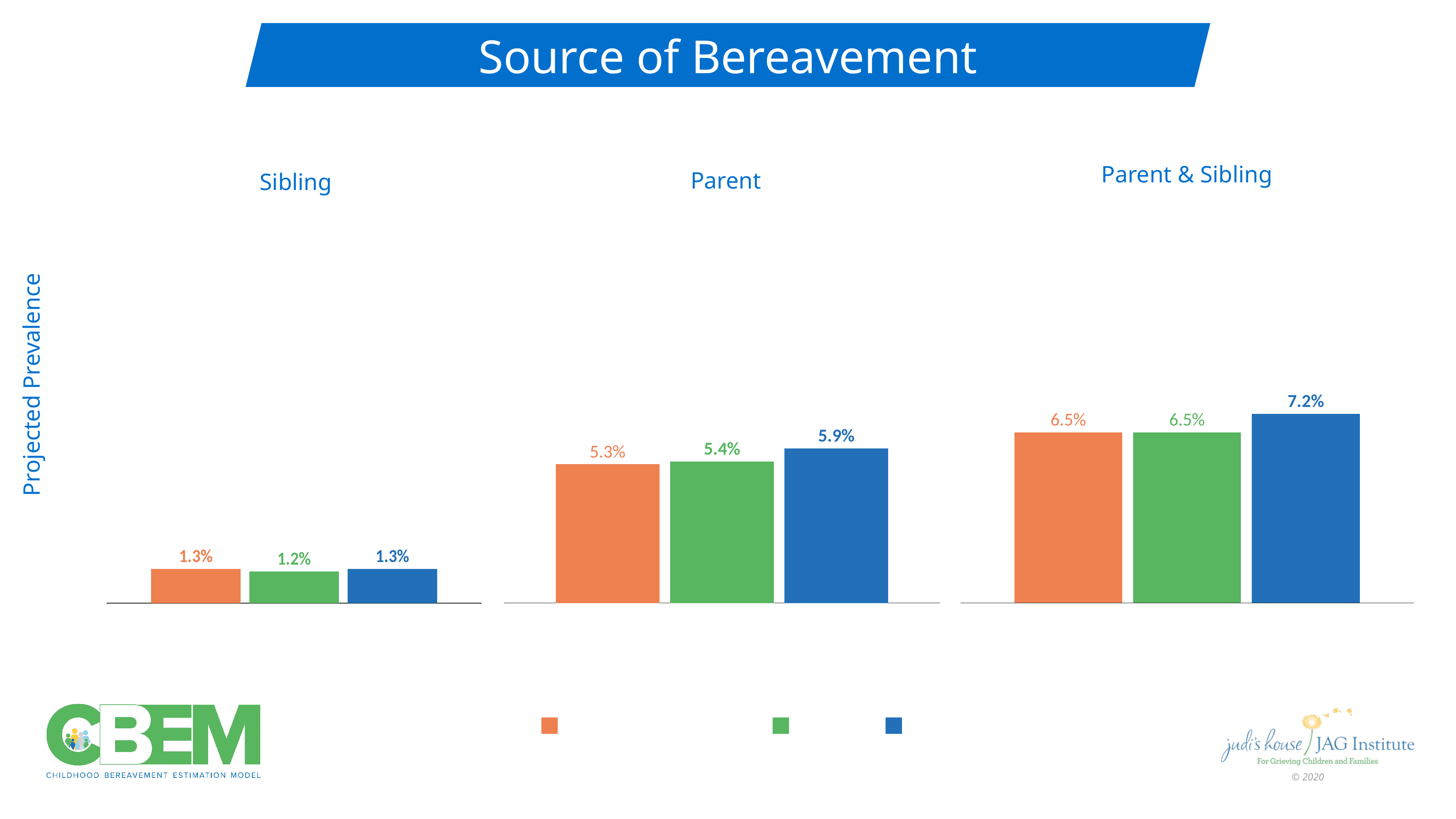
What type of chart is used on this slide? bar chart In the Parent chart, which coloured bar has the highest value? blue In the Sibling chart, which coloured bar has the lowest value? green In the Parent & Sibling chart, what is the difference between the blue bar and the orange bar? 0.7% In the Parent chart, what is the value of the blue bar? 5.9% In the Sibling chart, what is the value of the green bar? 1.2% How many bars are shown in the Parent chart? 3 In the Sibling chart, what is the value of the orange bar? 1.3% In the Parent chart, what is the difference between the blue bar and the green bar? 0.5% In the Parent & Sibling chart, what is the value of the green bar? 6.5% In the Parent chart, what is the value of the orange bar? 5.3% In the Parent & Sibling chart, what is the value of the blue bar? 7.2%